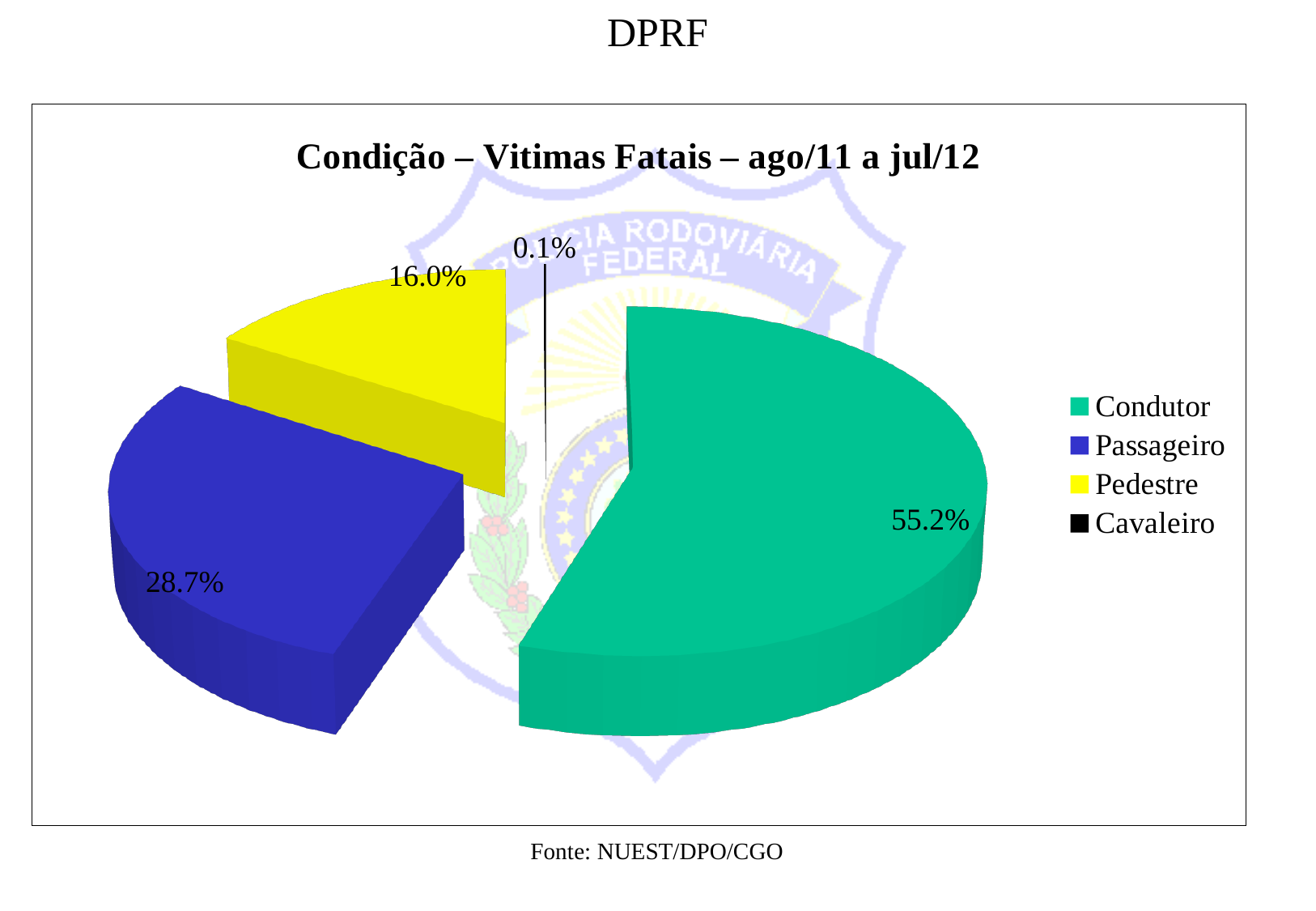
What share of the pie does Pedestre represent? 16.0% What is the difference in percentage points between the Passageiro and Pedestre shares? 12.7 How many categories does the legend list? 4 What share of the pie does Condutor represent? 55.2% What is the difference in percentage points between the Condutor and Passageiro shares? 26.5 What share of the pie does Cavaleiro represent? 0.1% Which category has the largest share of the pie? Condutor Which category has the smallest share of the pie? Cavaleiro What kind of chart is shown on the slide? Pie chart What is the title of the chart? Condição – Vitimas Fatais – ago/11 a jul/12 Which is larger, the share for Passageiro or the share for Pedestre? Passageiro